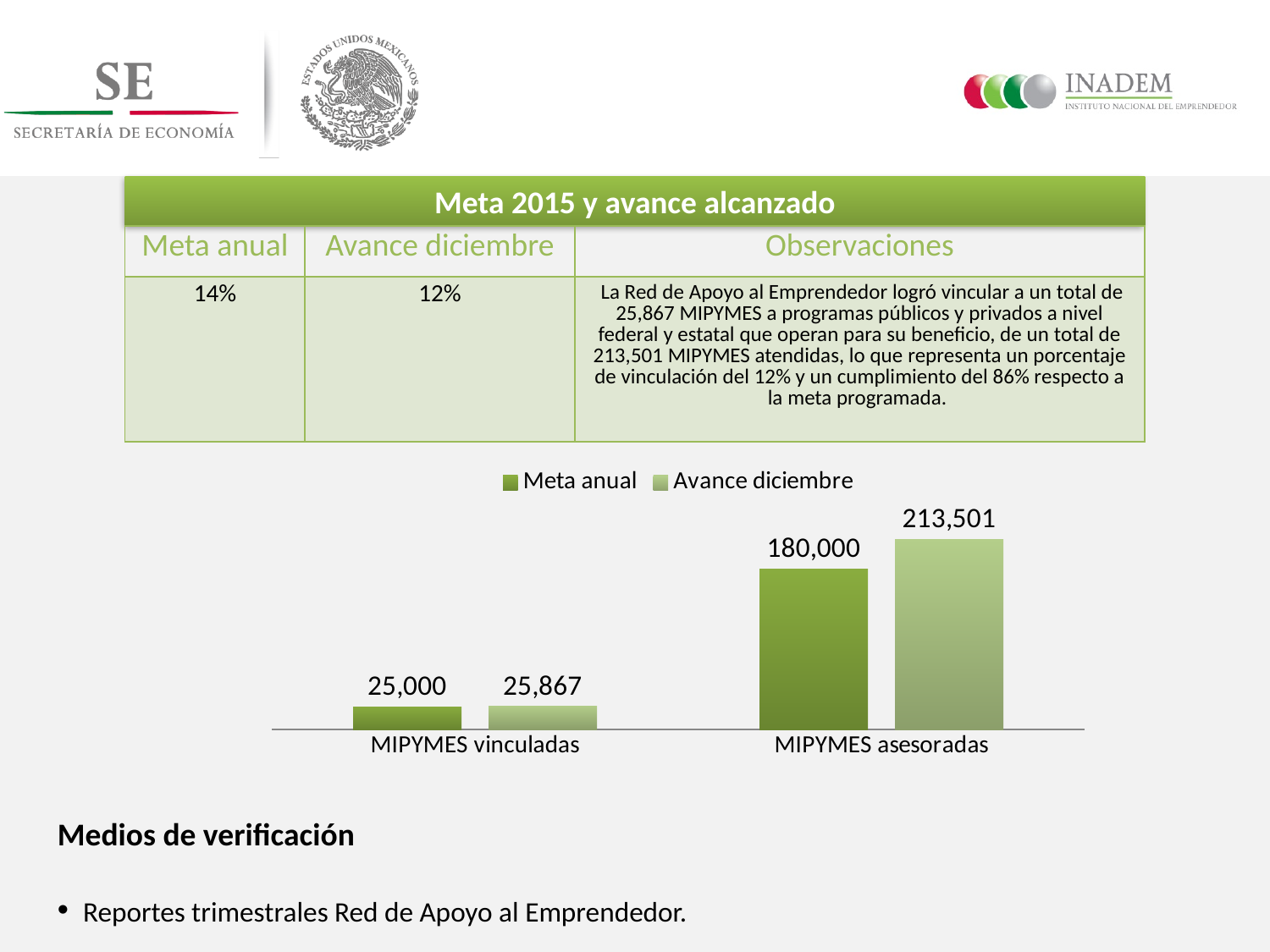
Which category has the lowest Meta anual value? MIPYMES vinculadas How many categories are shown on the x axis of the chart? 2 What kind of chart is shown on the slide? Bar chart For MIPYMES asesoradas, which is larger: Meta anual or Avance diciembre? Avance diciembre What is the Avance diciembre value for MIPYMES vinculadas? 25,867 What is the Avance diciembre value for MIPYMES asesoradas? 213,501 How many series does the chart legend list? 2 What is the difference between the Avance diciembre and Meta anual values for MIPYMES vinculadas? 867 What is the difference between the Avance diciembre and Meta anual values for MIPYMES asesoradas? 33,501 Which category has the highest Avance diciembre value? MIPYMES asesoradas What is the Meta anual value for MIPYMES asesoradas? 180,000 What is the Meta anual value for MIPYMES vinculadas? 25,000